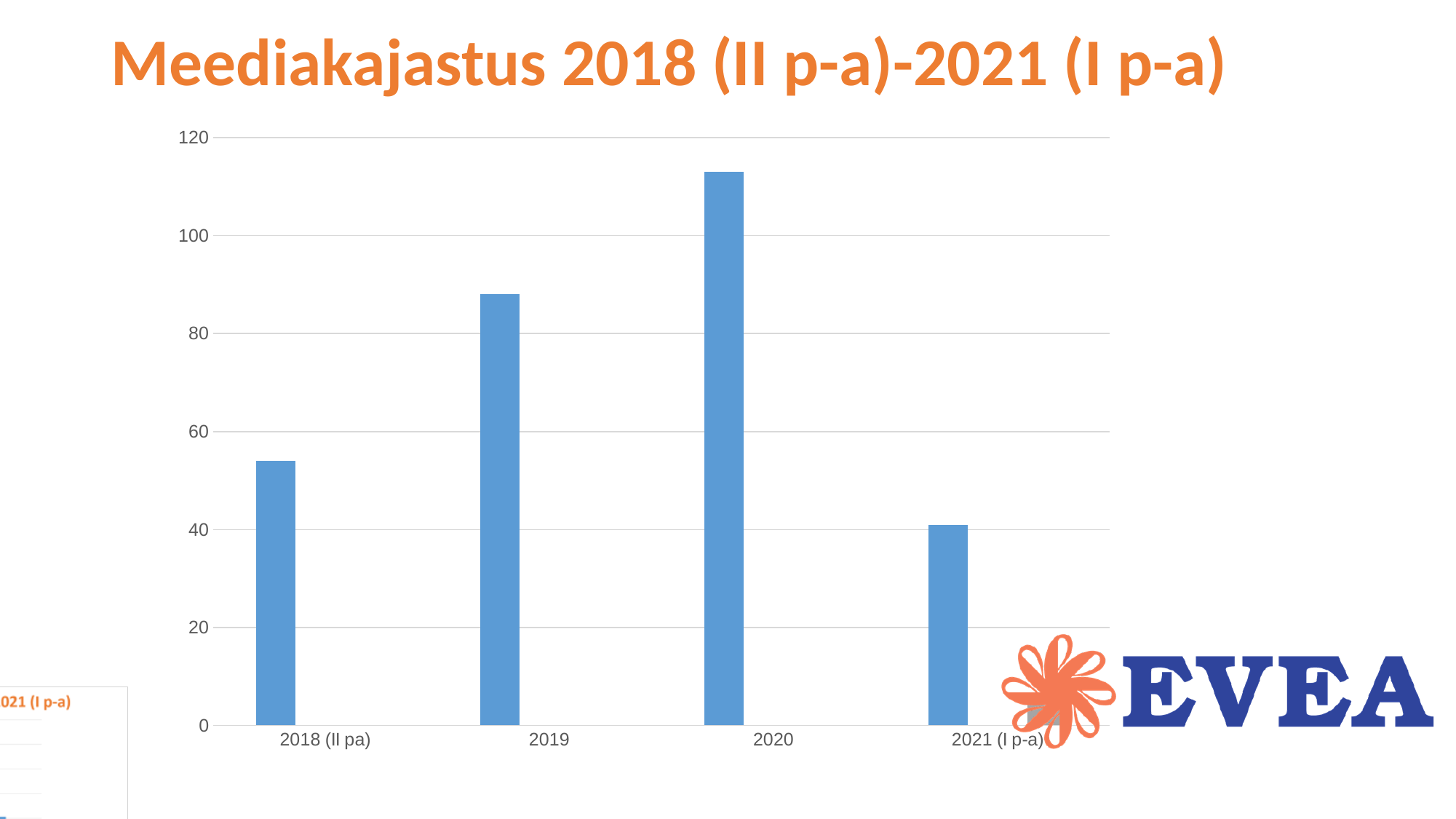
How many categories are plotted on the x axis of the chart? 4 Is the value for 2020 greater or less than 100? greater Is the value for 2019 greater or less than 80? greater What kind of chart is shown on the slide? bar chart Is the value for 2018 (II pa) greater or less than 60? less Do the values rise or fall from 2020 to 2021 (I p-a)? fall Which is larger, the value for 2021 (I p-a) or the value for 2020? 2020 Which category has the highest bar in the chart? 2020 Which is larger, the value for 2019 or the value for 2018 (II pa)? 2019 Which category has the lowest bar in the chart? 2021 (I p-a) What is the title of the slide containing the chart? Meediakajastus 2018 (II p-a)-2021 (I p-a)